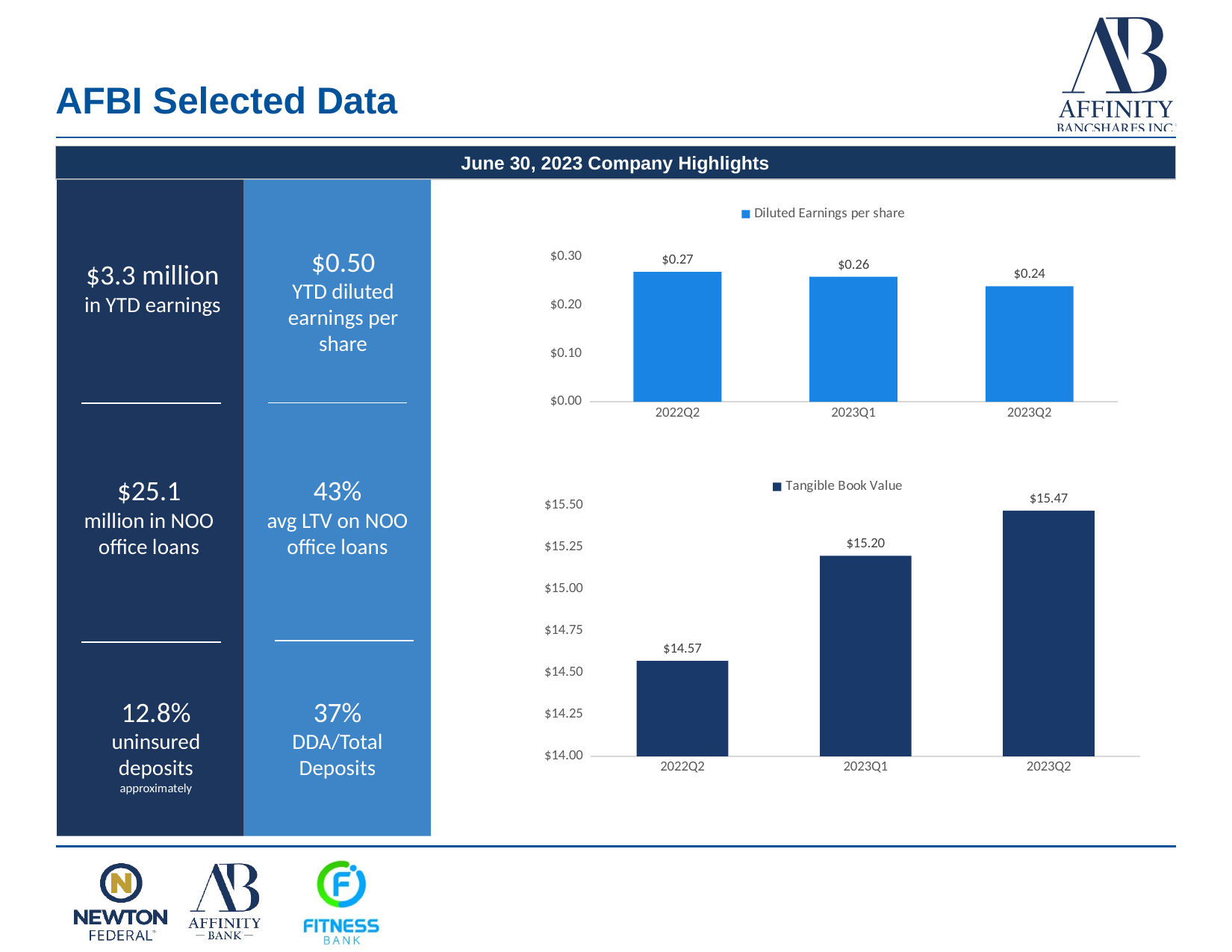
In the Diluted Earnings per share chart, do the values rise or fall from 2022Q2 to 2023Q2? fall In the Diluted Earnings per share chart, what is the value for 2023Q2? $0.24 In the Tangible Book Value chart, is the value for 2023Q1 greater or less than $15.00? greater In the Diluted Earnings per share chart, what is the value for 2022Q2? $0.27 In the Diluted Earnings per share chart, what is the difference between 2022Q2 and 2023Q2? $0.03 In the Diluted Earnings per share chart, which quarter has the lowest value? 2023Q2 In the Tangible Book Value chart, which quarter has the highest value? 2023Q2 In the Tangible Book Value chart, what is the value for 2022Q2? $14.57 In the Tangible Book Value chart, what is the value for 2023Q1? $15.20 In the Tangible Book Value chart, what is the difference between 2023Q2 and 2022Q2? $0.90 How many quarters are shown in the Tangible Book Value chart? 3 What kind of chart is the Diluted Earnings per share chart? bar chart